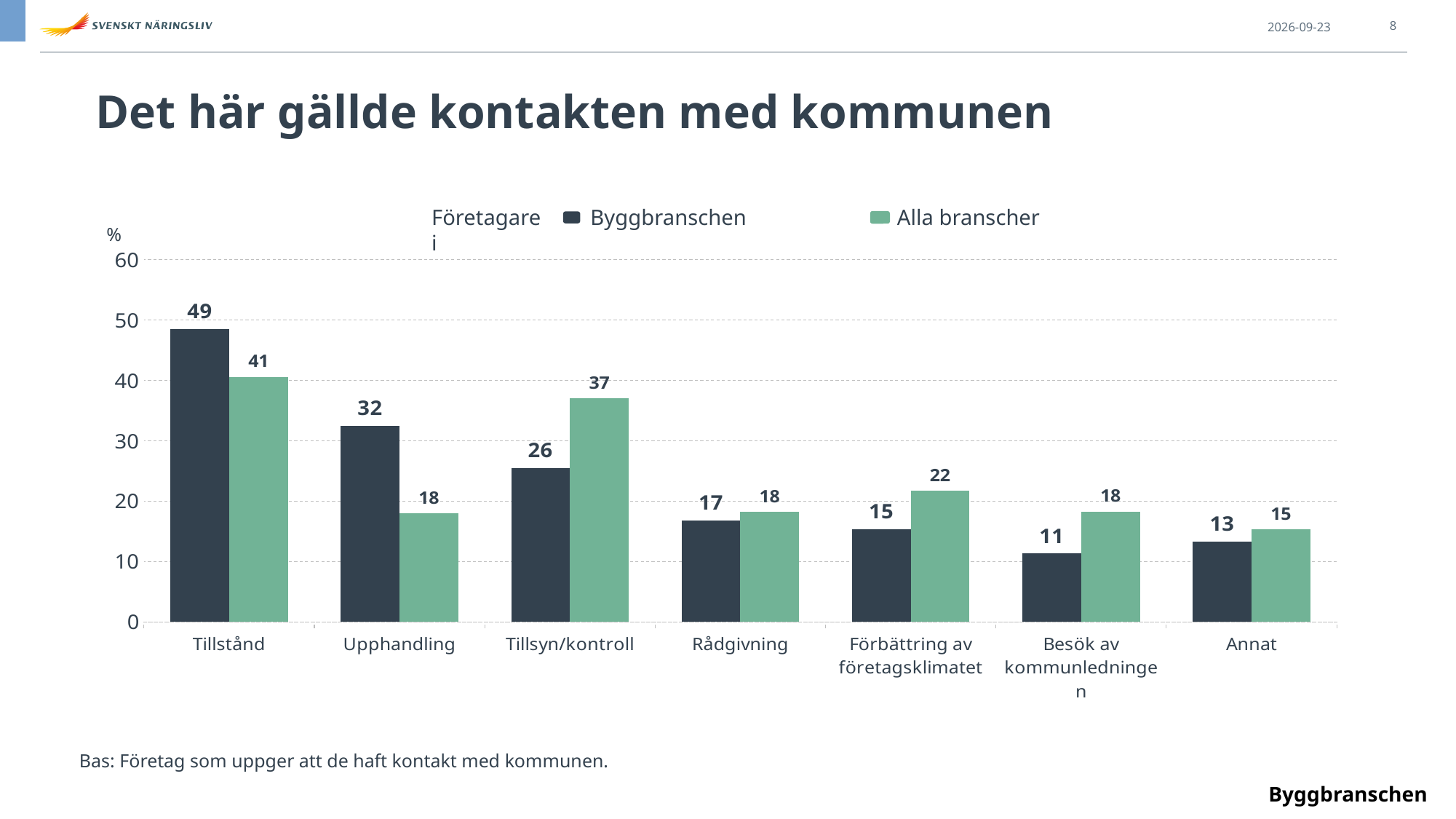
Which is larger in the Tillsyn/kontroll category, Byggbranschen or Alla branscher? Alla branscher What is the value for Alla branscher in the Tillsyn/kontroll category? 37 How many categories are shown on the x axis? 7 How many series does the legend list? 2 Which category has the highest value for Byggbranschen? Tillstånd What is the difference between Byggbranschen and Alla branscher in the Förbättring av företagsklimatet category? 7 What is the value for Byggbranschen in the Tillstånd category? 49 What is the title of the chart on the slide? Det här gällde kontakten med kommunen What kind of chart is shown on the slide? Bar chart What is the difference between Byggbranschen and Alla branscher in the Upphandling category? 14 What is the value for Alla branscher in the Upphandling category? 18 Which category has the lowest value for Byggbranschen? Besök av kommunledningen